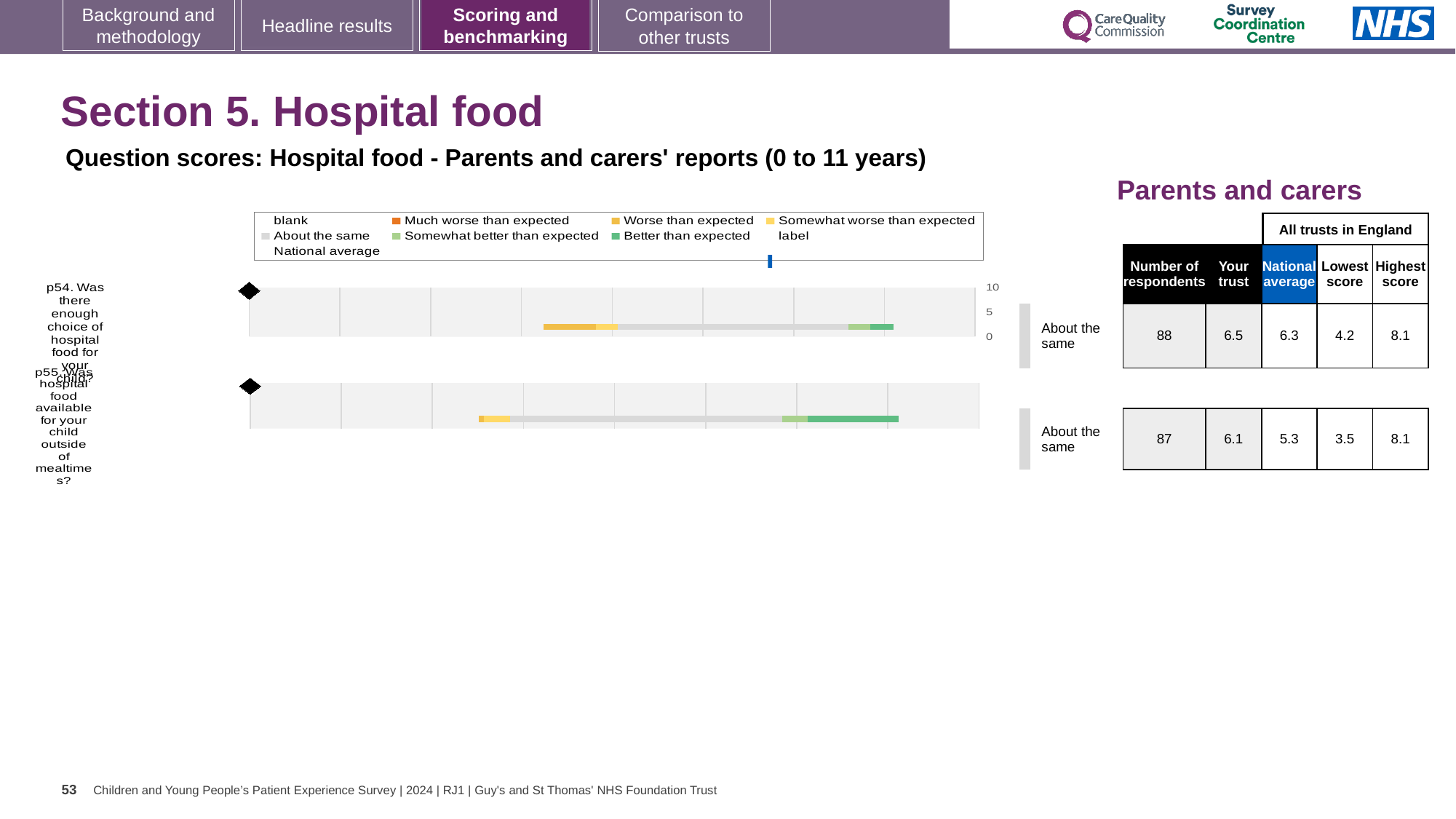
How many questions (categories) are plotted in the chart? 2 Which colour does the legend use for 'Much worse than expected'? orange What kind of chart is shown on the slide? bar chart How many entries does the chart legend list? 9 Which colour does the legend use for 'Better than expected'? green What is the highest value shown on the chart's axis? 10